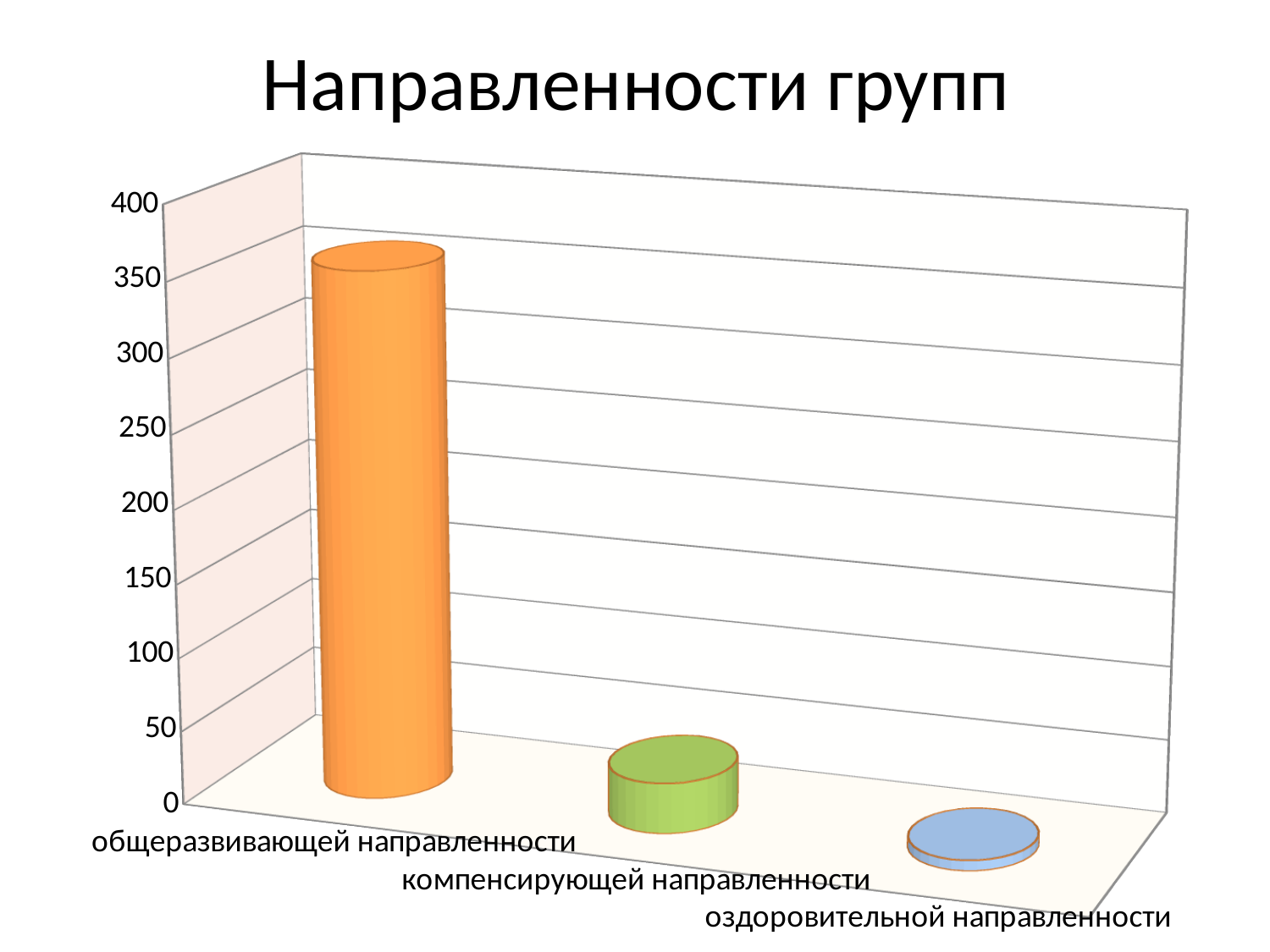
Is the value for оздоровительной направленности greater or less than 50? less Which category has the lowest value? оздоровительной направленности Is the value for компенсирующей направленности greater or less than 100? less What kind of chart is shown on the slide? bar chart What is the title of the chart? Направленности групп Which is larger: the value for общеразвивающей направленности or the value for компенсирующей направленности? общеразвивающей направленности Do the values rise or fall from left to right across the categories? fall How many categories are plotted in the chart? 3 Which category has the highest value? общеразвивающей направленности Which is larger: the value for компенсирующей направленности or the value for оздоровительной направленности? компенсирующей направленности What is the highest value shown on the vertical axis? 400 Is the value for общеразвивающей направленности greater or less than 300? greater